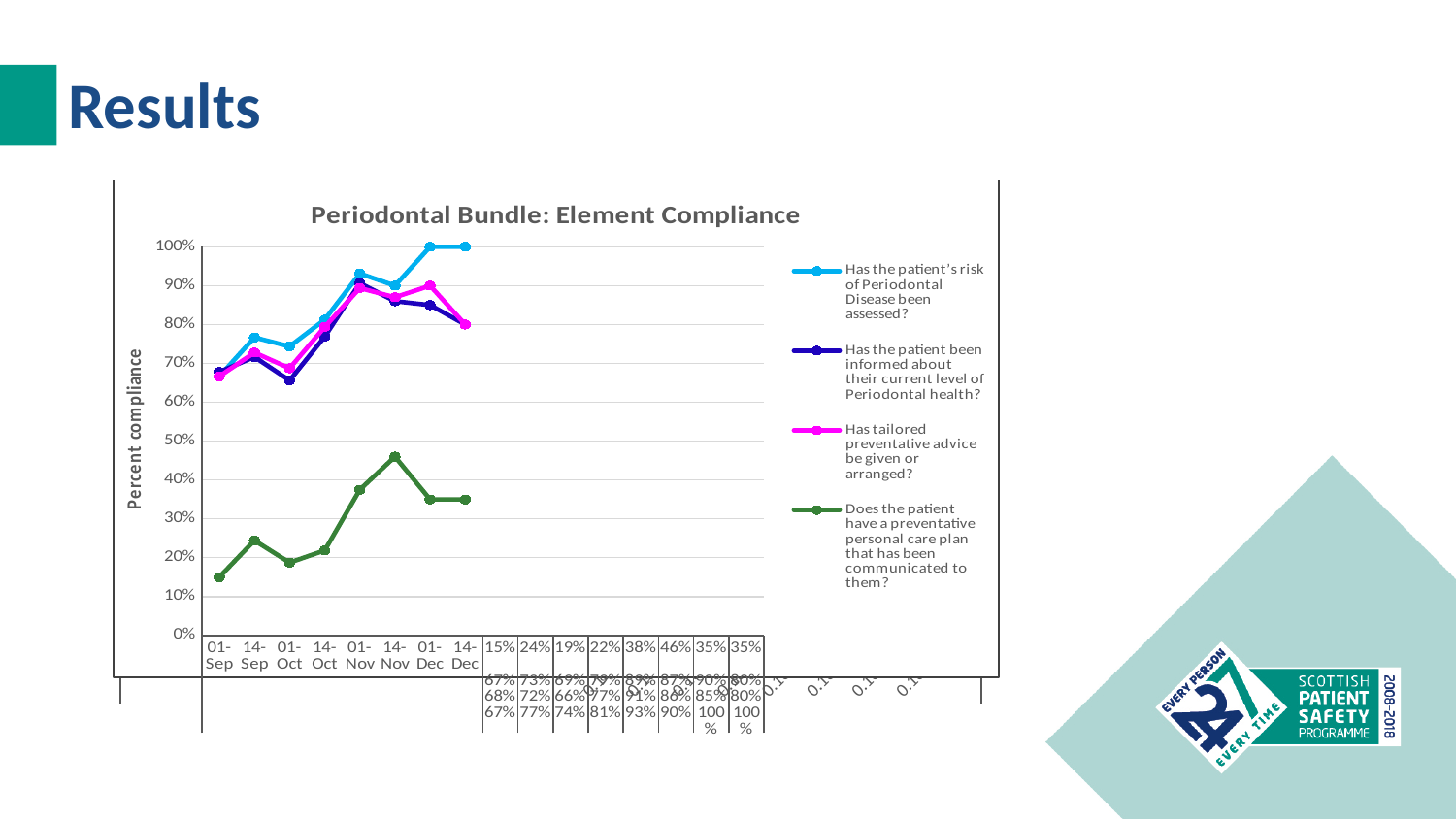
On 14-Nov, which series has the larger value: 'Has the patient's risk of Periodontal Disease been assessed?' or 'Does the patient have a preventative personal care plan'? Has the patient's risk of Periodontal Disease been assessed? What is the compliance value for 'Does the patient have a preventative personal care plan that has been communicated to them?' on 01-Sep? 15% What is the compliance value for 'Does the patient have a preventative personal care plan that has been communicated to them?' on 14-Nov? 46% What kind of chart is shown on the slide? Line chart What is the compliance value for 'Has the patient's risk of Periodontal Disease been assessed?' on 01-Dec? 100% How many dates are plotted along the x axis of the chart? 8 What is the title of the chart? Periodontal Bundle: Element Compliance How many series does the chart's legend list? 4 What is the label of the vertical axis? Percent compliance On which date does the 'Does the patient have a preventative personal care plan' series reach its highest value? 14-Nov On which date is the 'Does the patient have a preventative personal care plan' series at its lowest value? 01-Sep What is the difference between the 14-Nov and 01-Sep values of the 'Does the patient have a preventative personal care plan' series? 31 percentage points